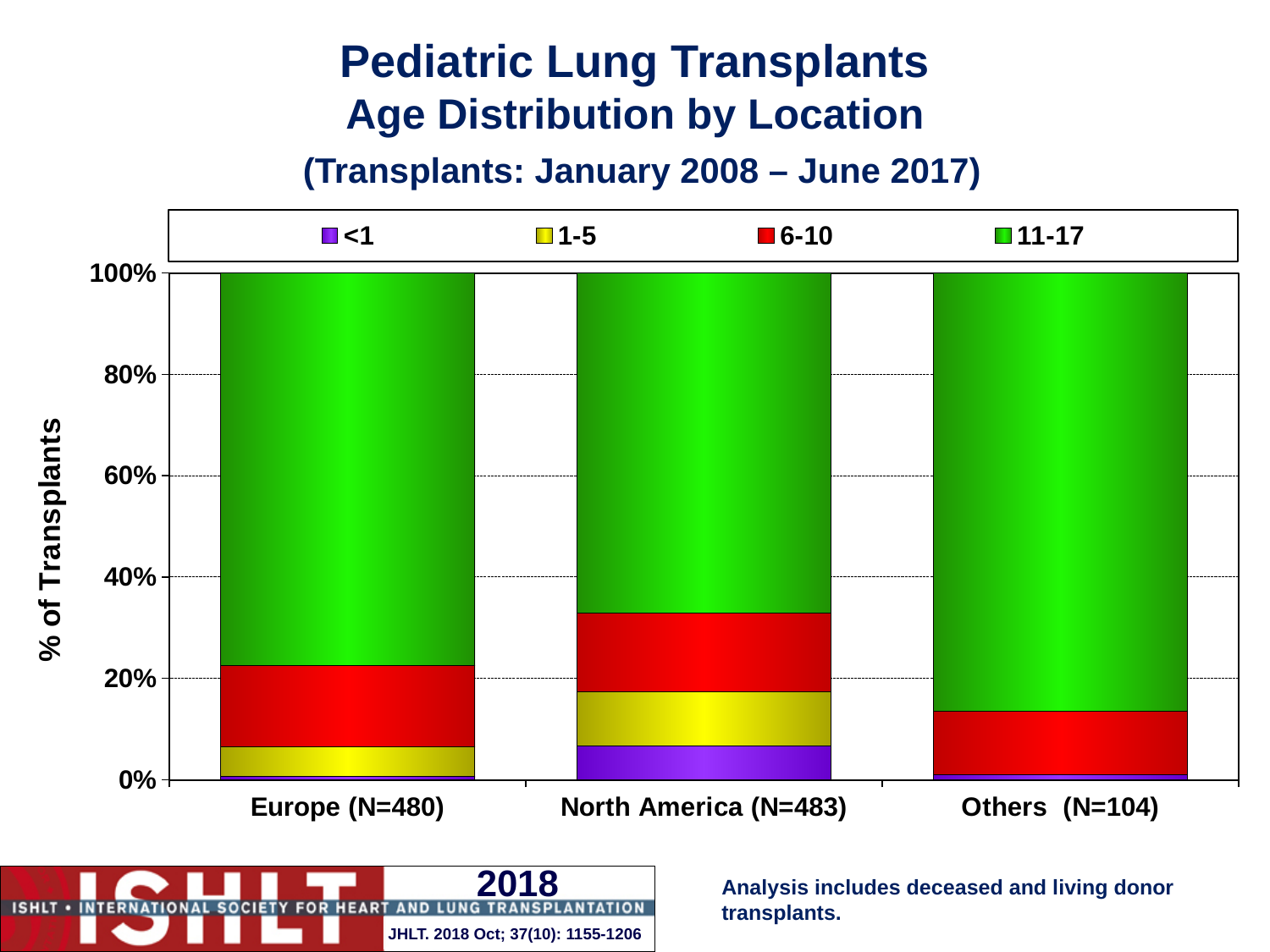
Is the share of the 1-5 age group for North America (N=483) greater or less than 20%? less What is the total height of each stacked bar? 100% Which colour represents the 6-10 age group in the legend? Red What is the label of the y axis? % of Transplants How many age-group series does the legend list? 4 Which location has the largest share of transplants in the 11-17 age group? Others (N=104) Is the share of the 6-10 age group for Others (N=104) greater or less than 20%? less What kind of chart is shown on the slide? Stacked bar chart Which location has a larger share of transplants in the <1 age group, Europe (N=480) or North America (N=483)? North America (N=483) Is the share of the 11-17 age group for Europe (N=480) greater or less than 60%? greater Which location has the smallest share of transplants in the 11-17 age group? North America (N=483) How many locations (categories) are shown on the x axis? 3